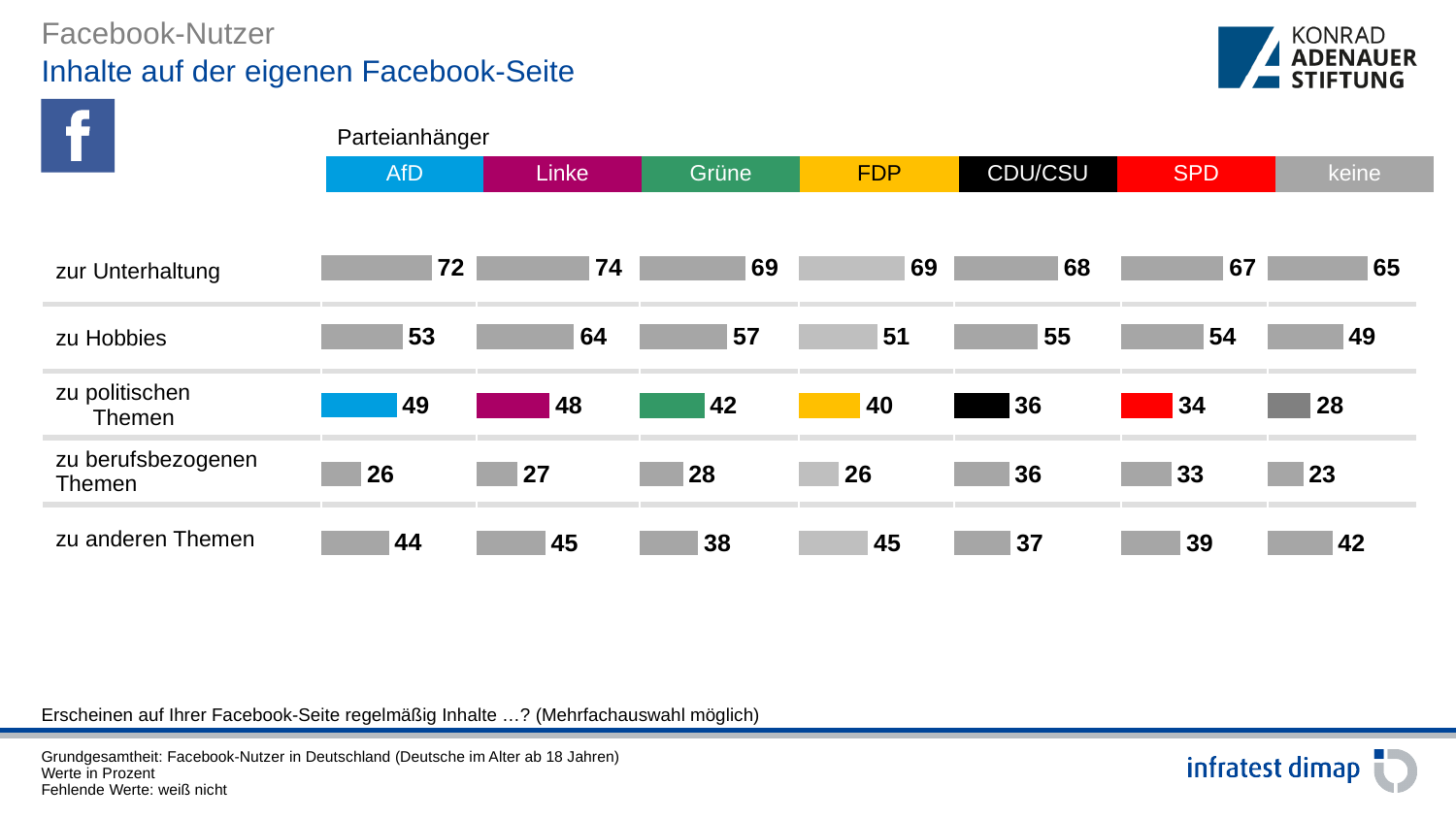
What is the value for 'zu berufsbezogenen Themen' among CDU/CSU supporters? 36 What kind of chart is used to display the values on this slide? bar chart What is the value for 'zu anderen Themen' among supporters of no party ('keine')? 42 What is the value for 'zur Unterhaltung' among Linke supporters? 74 How many party groups are shown as columns in the chart? 7 What is the value for 'zu politischen Themen' among AfD supporters? 49 Which party group has the lowest value for 'zu politischen Themen'? keine Which is larger for FDP supporters: 'zu Hobbies' or 'zu anderen Themen'? zu Hobbies Do the values for 'zu politischen Themen' rise or fall from AfD to 'keine' across the columns? fall Which party group has the highest value for 'zu Hobbies'? Linke How many content categories (rows) are shown in the chart? 5 What is the difference between the AfD and SPD values for 'zu politischen Themen'? 15